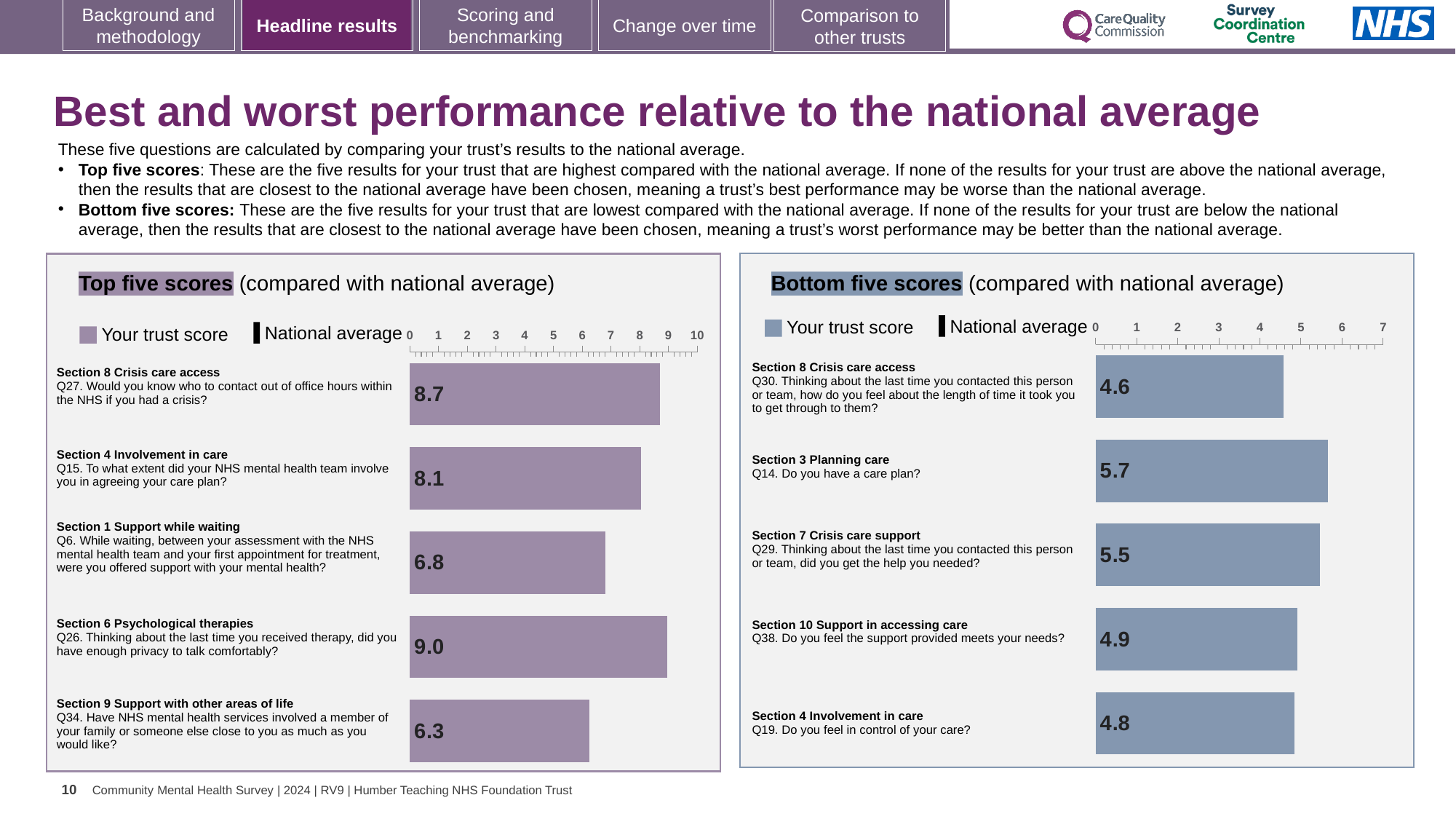
In the Top five scores chart, what is the trust score for Q27 (Section 8 Crisis care access)? 8.7 In the Bottom five scores chart, which question has the highest trust score? Q14 (Section 3 Planning care) In the Bottom five scores chart, which has the larger trust score, Q29 or Q38? Q29 What type of chart is the Top five scores chart? Bar chart In the Bottom five scores chart, what is the trust score for Q14 (Section 3 Planning care)? 5.7 In the Top five scores chart, which question has the lowest trust score? Q34 (Section 9 Support with other areas of life) In the Top five scores chart, how many questions are plotted? 5 In the Bottom five scores chart, which question has the lowest trust score? Q30 (Section 8 Crisis care access) How many series does the legend of the Bottom five scores chart list? 2 In the Top five scores chart, what is the difference between the trust scores for Q26 and Q34? 2.7 In the Top five scores chart, which question has the highest trust score? Q26 (Section 6 Psychological therapies) In the Bottom five scores chart, what is the difference between the trust scores for Q14 and Q30? 1.1